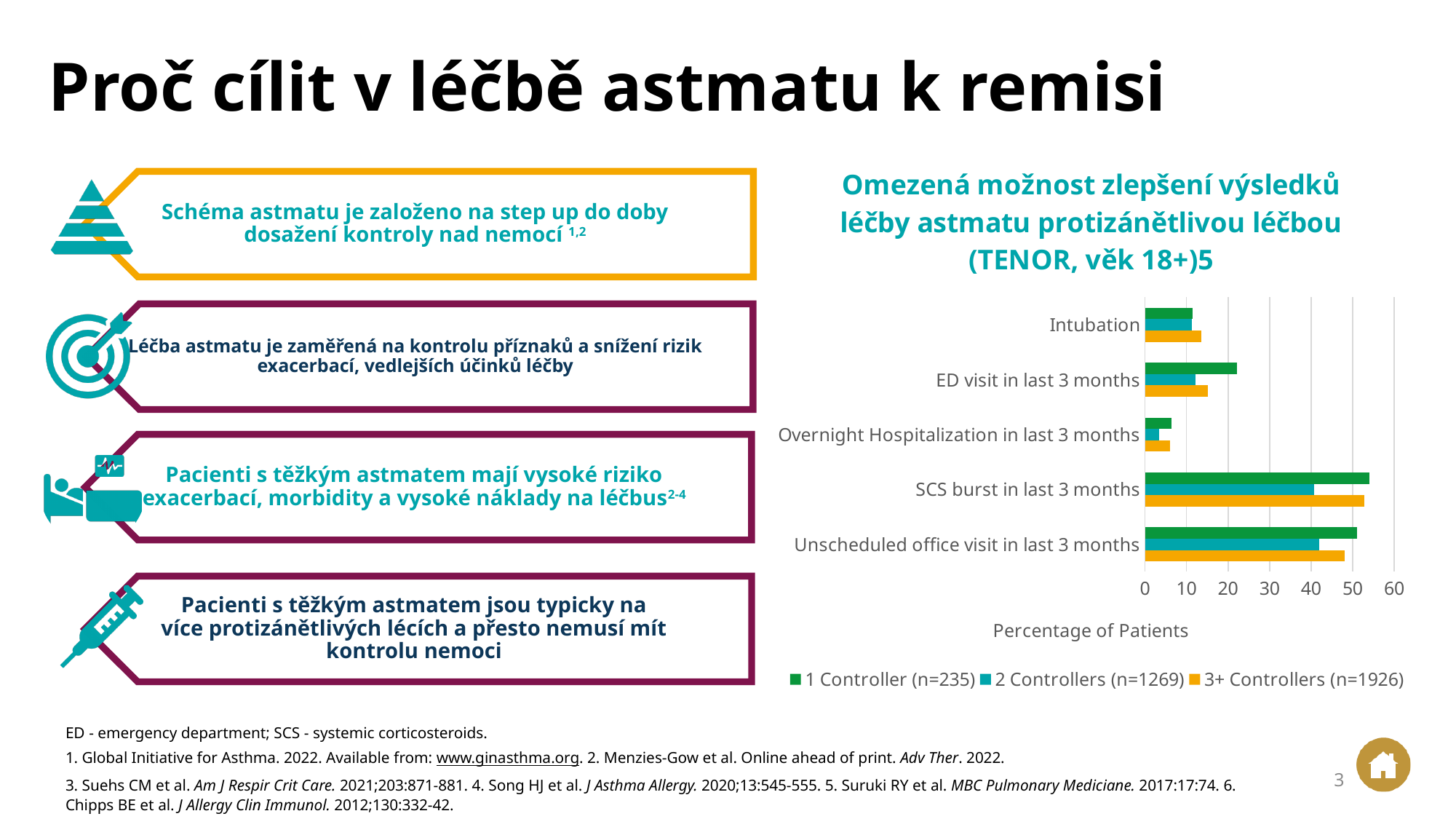
Is the value for SCS burst in last 3 months in the 1 Controller (n=235) series greater or less than 50? greater What is the title of the chart's horizontal axis? Percentage of Patients For SCS burst in last 3 months, which series has the larger value: 2 Controllers (n=1269) or 3+ Controllers (n=1926)? 3+ Controllers (n=1926) Which category has the lowest value for the 1 Controller (n=235) series? Overnight Hospitalization in last 3 months Which category has the highest value for the 2 Controllers (n=1269) series? Unscheduled office visit in last 3 months Is the value for Unscheduled office visit in last 3 months in the 2 Controllers (n=1269) series greater or less than 50? less According to the legend, what is the n for the 3+ Controllers series? 1926 For ED visit in last 3 months, which series has the larger value: 1 Controller (n=235) or 2 Controllers (n=1269)? 1 Controller (n=235) What kind of chart is shown on the slide? Bar chart How many series does the chart legend list? 3 Is the value for Overnight Hospitalization in last 3 months in the 2 Controllers (n=1269) series greater or less than 10? less How many categories are plotted on the chart's vertical axis? 5